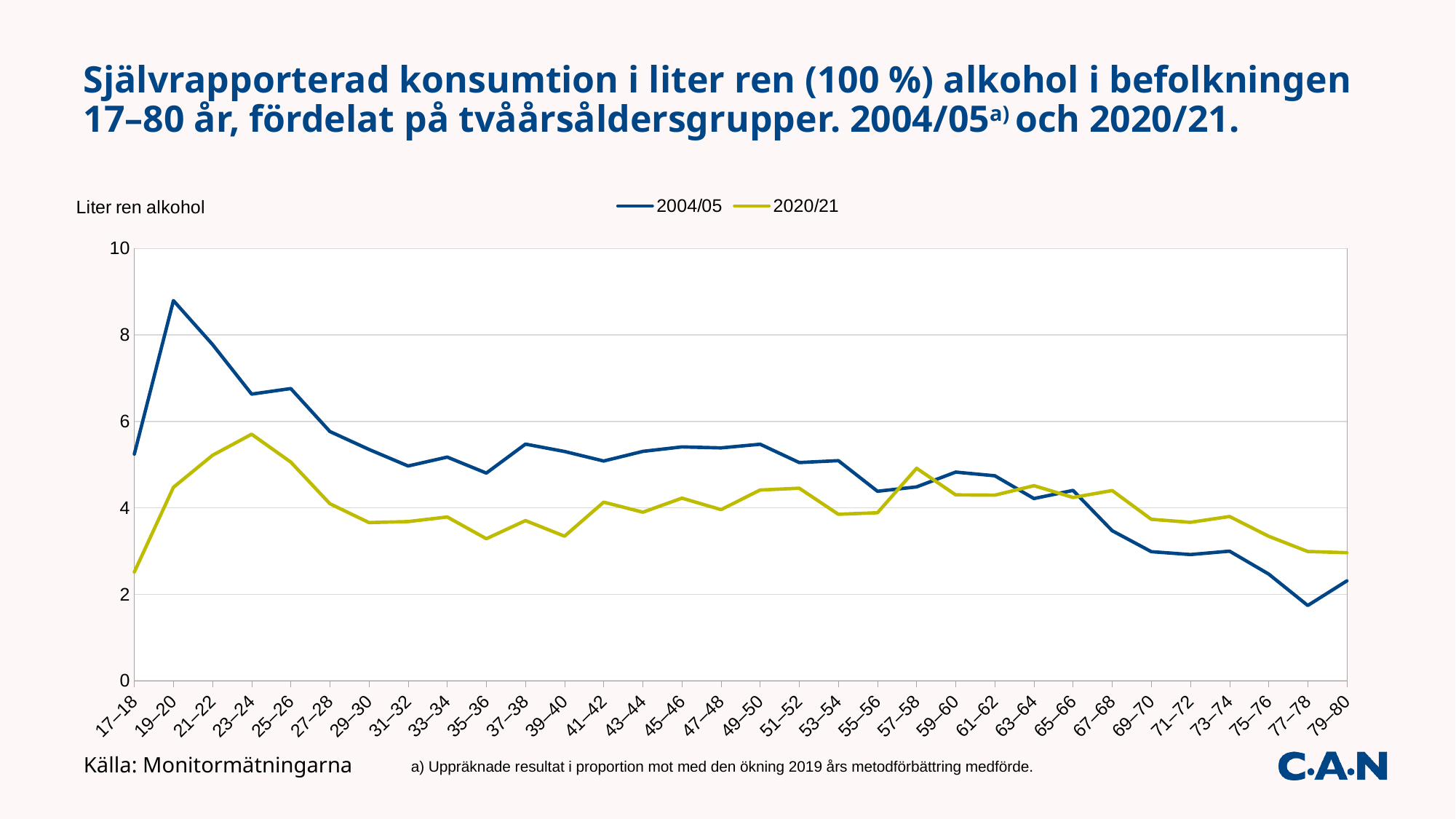
Which age group has the highest value for the 2004/05 series? 19–20 Is the 2004/05 value for the 19–20 age group greater or less than 8? greater Which age group has the lowest value for the 2020/21 series? 17–18 Which age group has the lowest value for the 2004/05 series? 77–78 Is the 2004/05 value for the 77–78 age group greater or less than 2? less For the 17–18 age group, which series has the larger value, 2004/05 or 2020/21? 2004/05 How many age groups are shown on the x axis? 32 What kind of chart is shown on the slide? Line chart Is the 2020/21 value for the 23–24 age group greater or less than 6? less Which age group has the highest value for the 2020/21 series? 23–24 For the 79–80 age group, which series has the larger value, 2004/05 or 2020/21? 2020/21 How many series does the legend list? 2